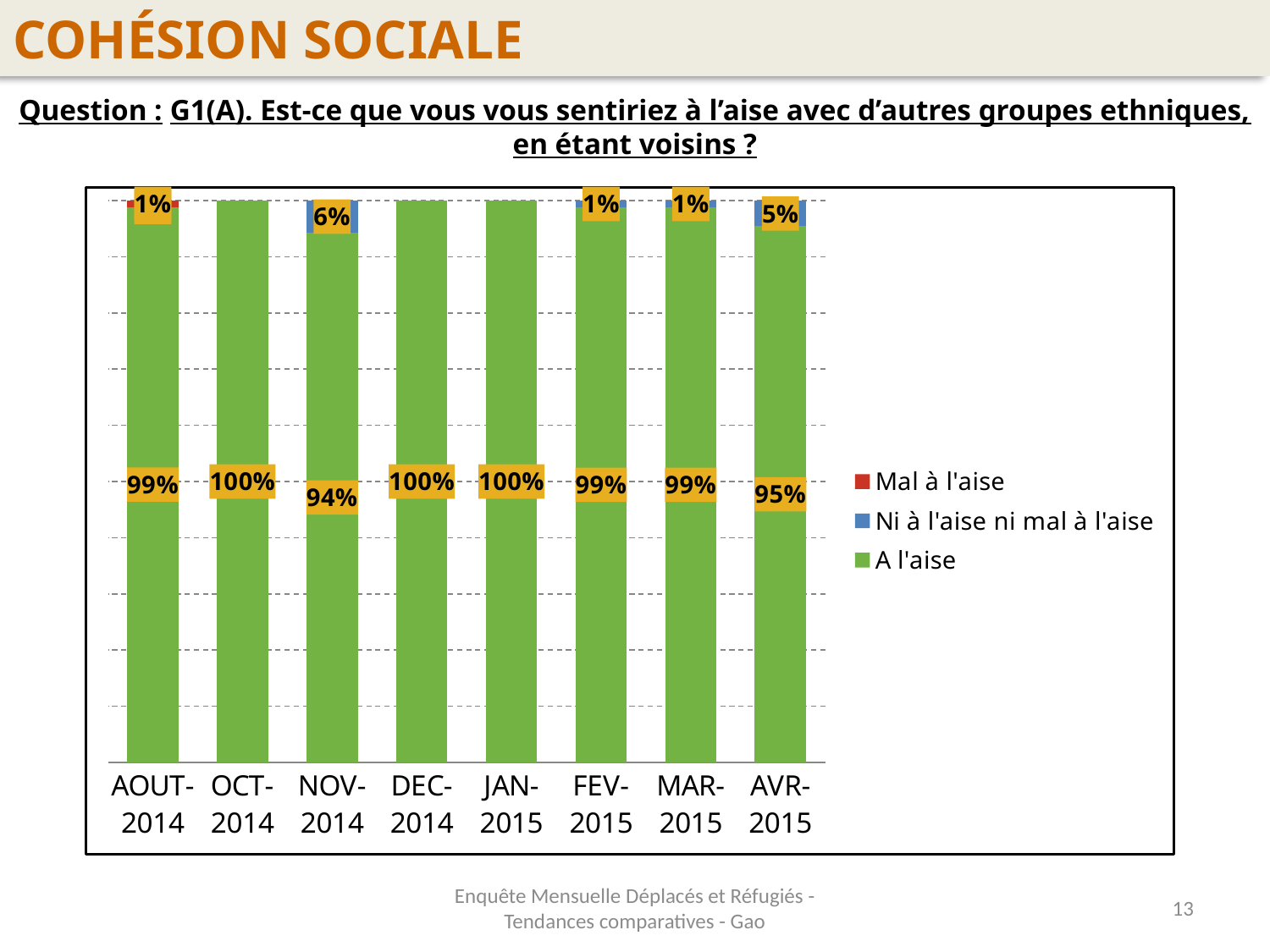
What is the value of 'Ni à l'aise ni mal à l'aise' for AVR-2015? 5% What is the value of 'A l'aise' for AVR-2015? 95% What is the value of 'Ni à l'aise ni mal à l'aise' for NOV-2014? 6% What is the difference between the 'A l'aise' values for OCT-2014 and NOV-2014? 6% How many series does the chart legend list? 3 What is the value of 'A l'aise' for AOUT-2014? 99% Which is larger, the 'A l'aise' value for MAR-2015 or for AVR-2015? MAR-2015 How many months are shown on the x axis of the chart? 8 Which month has the lowest value for 'A l'aise'? NOV-2014 What is the value of 'A l'aise' for NOV-2014? 94% What type of chart is shown on the slide? stacked bar chart Which legend entry is shown in green? A l'aise